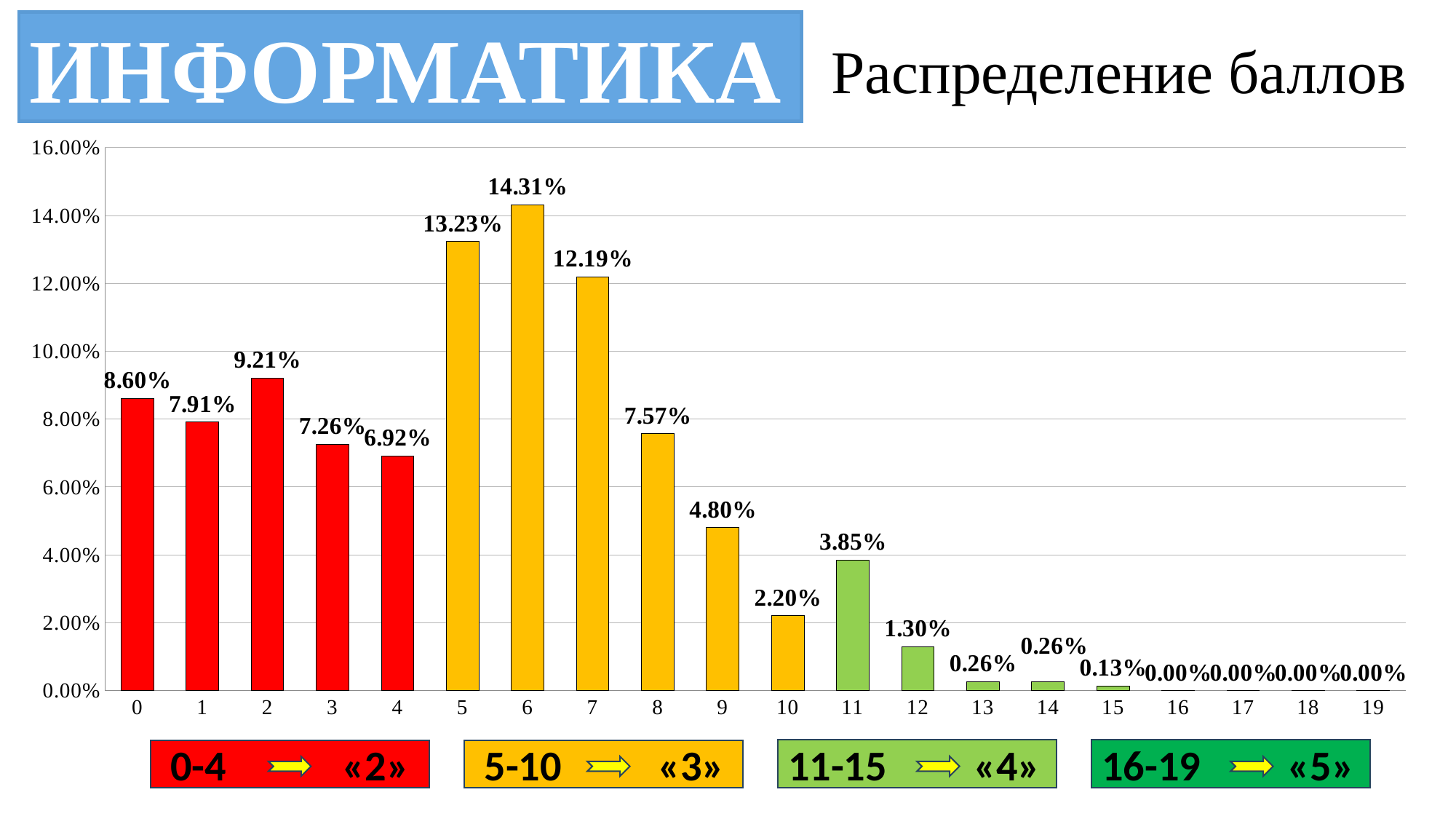
Do the values rise or fall from score 6 to score 10? fall What is the value for score 15? 0.13% What is the value for score 11? 3.85% Which is larger, the value for score 2 or the value for score 0? score 2 What is the difference between the values for score 0 and score 4? 1.68% Is the value for score 9 greater or less than 6.00%? less Among scores 0 to 4, which has the lowest percentage? 4 What is the value for score 6? 14.31% Which score has the highest percentage? 6 What kind of chart is shown on the slide? bar chart What is the difference between the values for score 6 and score 5? 1.08% How many score categories are shown on the x axis? 20